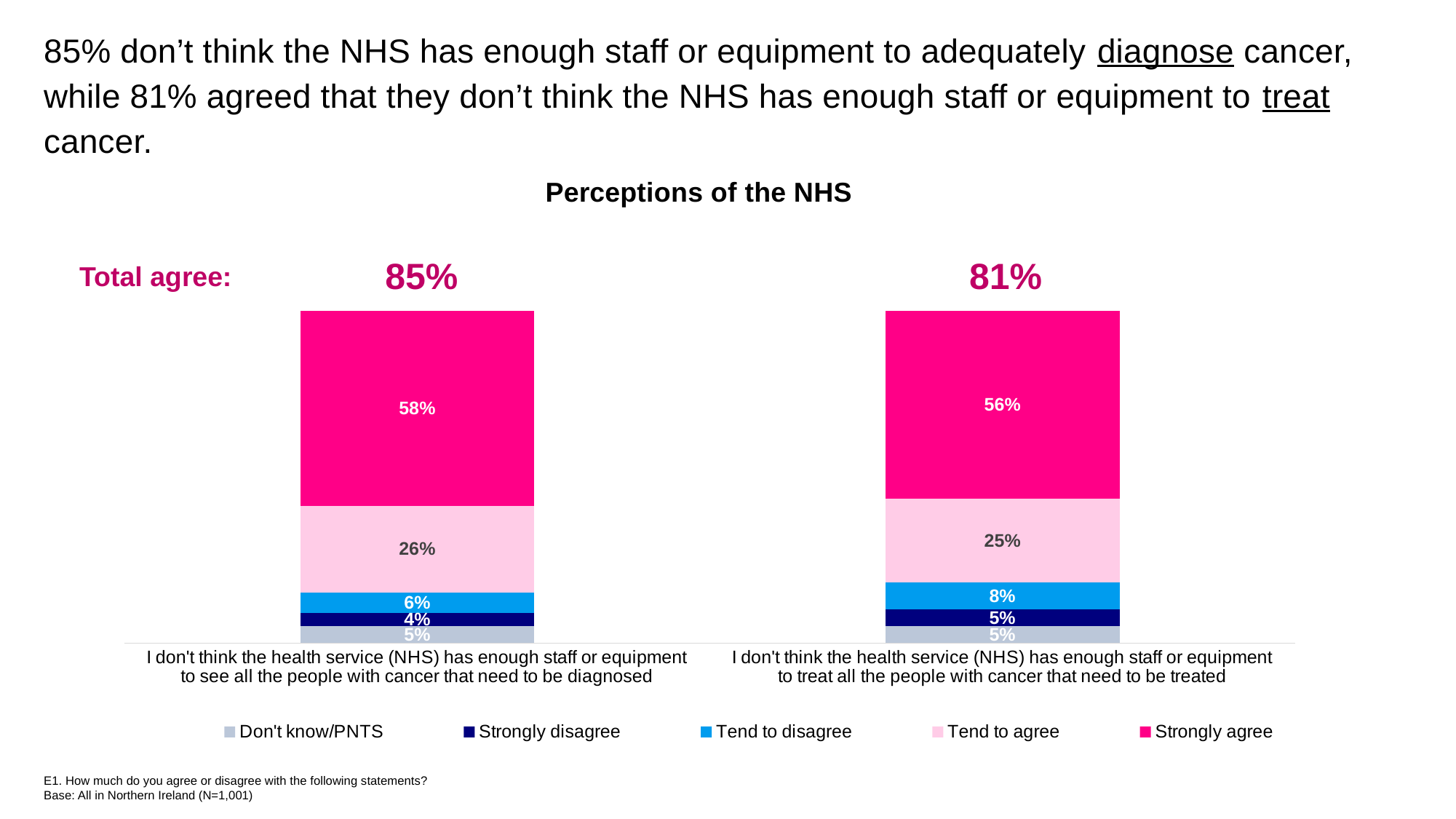
How many bars (statements) are plotted in the chart? 2 What percentage strongly disagree with the statement about the NHS not having enough staff or equipment to see all the people with cancer that need to be diagnosed? 4% What is the difference between the 'Strongly agree' percentages for the diagnose statement and the treat statement? 2% What type of chart is shown on the slide? Stacked bar chart What percentage strongly agree that the NHS does not have enough staff or equipment to see all the people with cancer that need to be diagnosed? 58% What is the title of the chart? Perceptions of the NHS What percentage tend to disagree with the statement about the NHS not having enough staff or equipment to treat all the people with cancer that need to be treated? 8% How many series does the legend list? 5 What percentage tend to agree that the NHS does not have enough staff or equipment to treat all the people with cancer that need to be treated? 25% Which statement has the higher 'Strongly agree' percentage: the one about diagnosing cancer or the one about treating cancer? The one about diagnosing cancer Which series is shown in the darkest navy colour in the legend? Strongly disagree What is the total agree figure shown for the statement about treating all the people with cancer that need to be treated? 81%